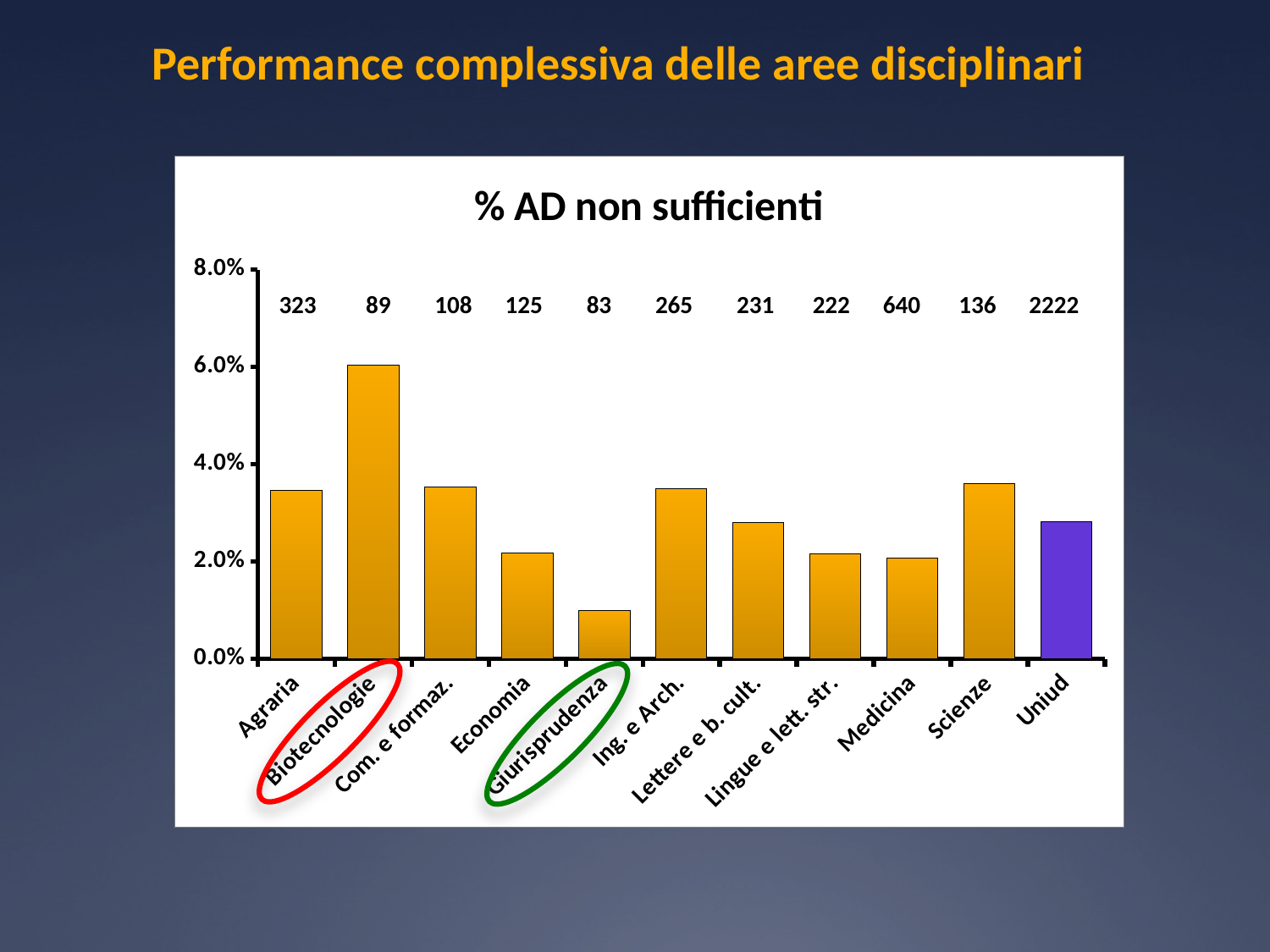
What kind of chart is shown on the slide? bar chart Is the value for Biotecnologie greater or less than 4.0%? greater Which has a higher % AD non sufficienti, Scienze or Uniud? Scienze What is the title of the chart? % AD non sufficienti Is the value for Uniud greater or less than 2.0%? greater Which category has the highest % AD non sufficienti? Biotecnologie What number is printed above the Medicina bar? 640 How many categories are shown on the x axis of the chart? 11 Which has a higher % AD non sufficienti, Agraria or Biotecnologie? Biotecnologie Is the value for Scienze greater or less than 4.0%? less Which category has the lowest % AD non sufficienti? Giurisprudenza